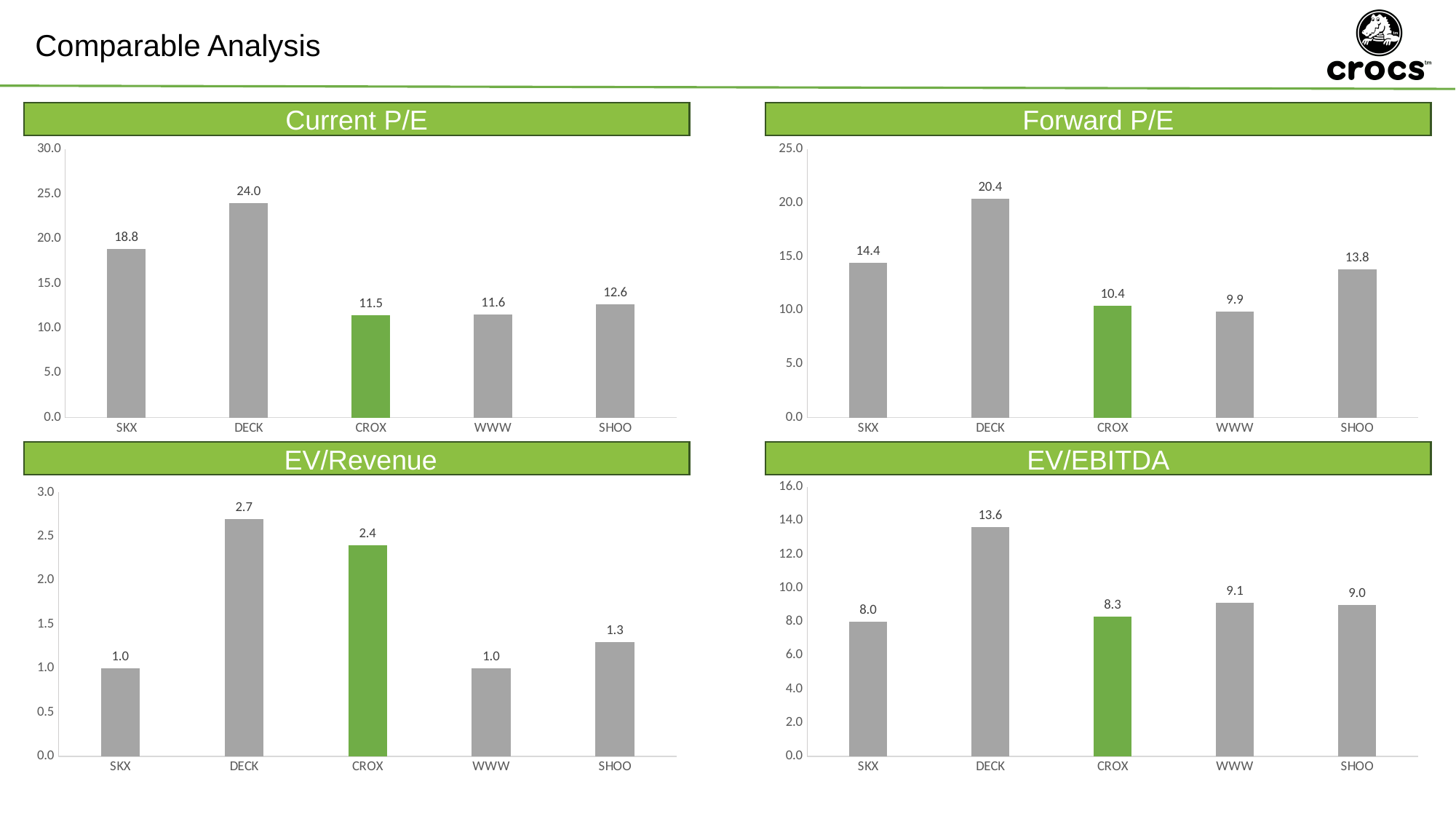
In the Forward P/E chart, is the value for SHOO greater or less than 10.0? greater In the EV/EBITDA chart, which company has the highest value? DECK Which company's bar is coloured green in each of the four charts? CROX In the EV/EBITDA chart, what is the difference between DECK and WWW? 4.5 In the Forward P/E chart, which company has the lowest value? WWW What kind of chart is the Current P/E chart? Bar chart In the Forward P/E chart, what is the value for CROX? 10.4 In the Current P/E chart, what is the value for DECK? 24.0 In the EV/Revenue chart, what is the value for SHOO? 1.3 In the EV/EBITDA chart, which is larger, the value for SKX or the value for CROX? CROX In the Current P/E chart, what is the difference between DECK and SKX? 5.2 How many companies are shown in the EV/Revenue chart? 5